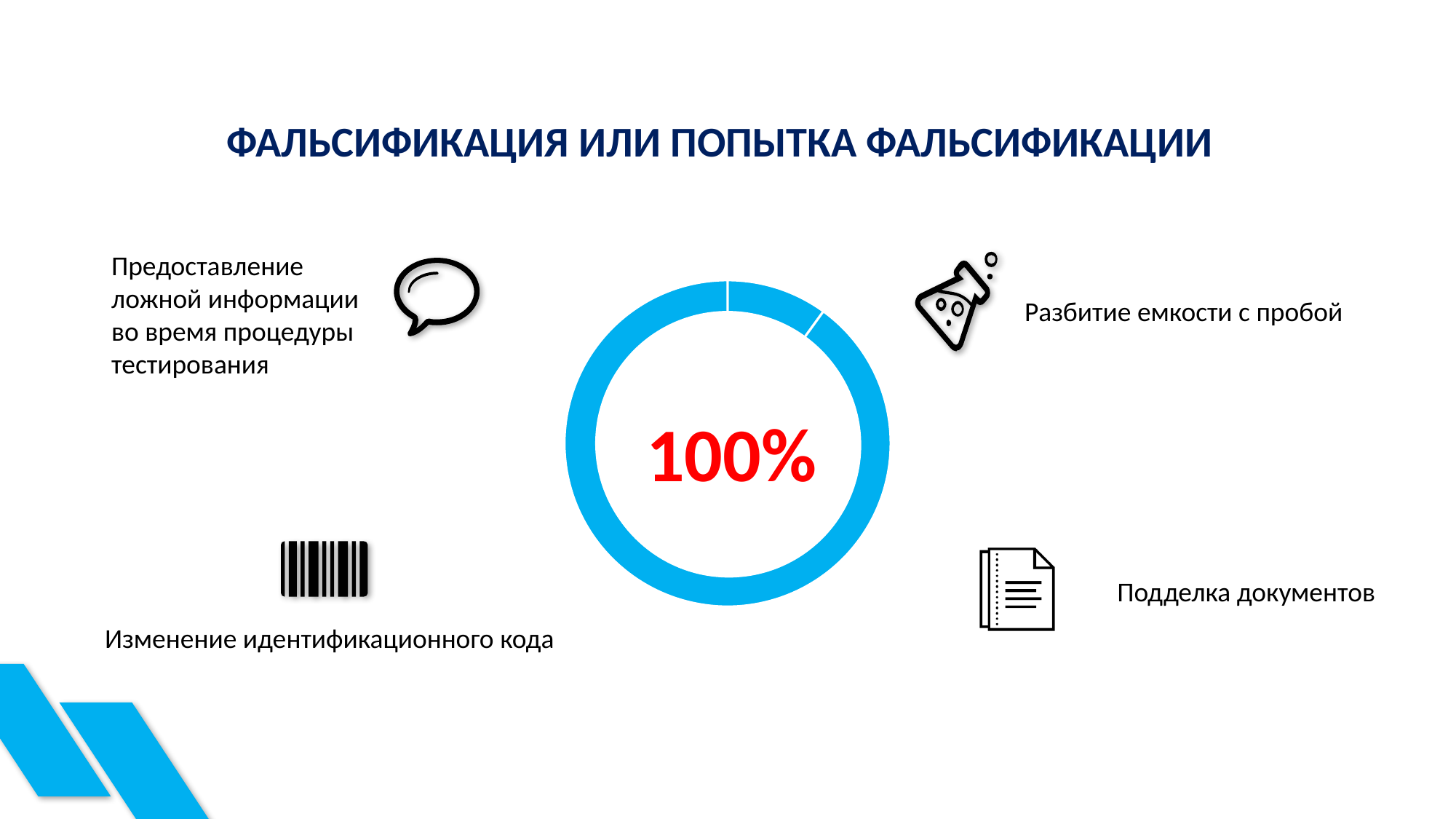
What kind of chart is shown in the centre of the slide? donut (pie) chart What is the title shown at the top of the slide above the chart? ФАЛЬСИФИКАЦИЯ ИЛИ ПОПЫТКА ФАЛЬСИФИКАЦИИ What value is printed in the centre of the donut chart? 100% What colour is the ring of the donut chart? blue